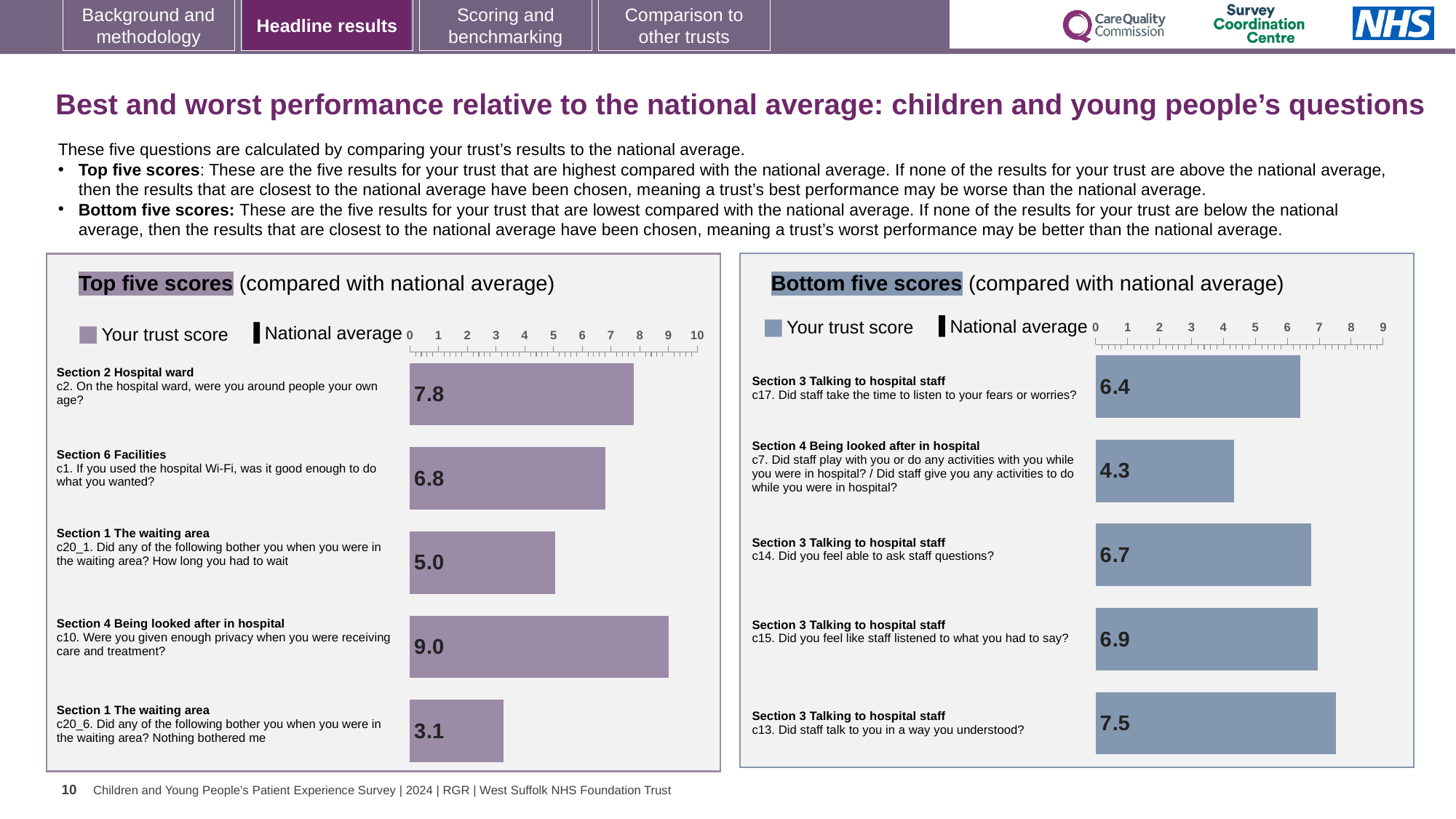
In the Bottom five scores chart, which is larger: the trust score for c14 or for c15? c15 In the Bottom five scores chart, what is the difference between the trust scores for c13 and c17? 1.1 In the Top five scores chart, which question has the highest trust score? c10. Were you given enough privacy when you were receiving care and treatment? In the Top five scores chart, what is the trust score for c2 (On the hospital ward, were you around people your own age?)? 7.8 What kind of chart is the Bottom five scores chart? Bar chart In the Bottom five scores chart, which question has the lowest trust score? c7. Did staff play with you or do any activities with you while you were in hospital? In the Top five scores chart, what is the difference between the trust scores for c10 and c20_6? 5.9 In the Bottom five scores chart, what is the trust score for c13 (Did staff talk to you in a way you understood?)? 7.5 In the Top five scores chart, which question has the lowest trust score? c20_6. Did any of the following bother you when you were in the waiting area? Nothing bothered me How many questions are plotted in the Top five scores chart? 5 In the Bottom five scores chart, what is the trust score for c7 (Did staff play with you or do any activities with you while you were in hospital?)? 4.3 In the Top five scores chart, what is the trust score for c1 (hospital Wi-Fi)? 6.8